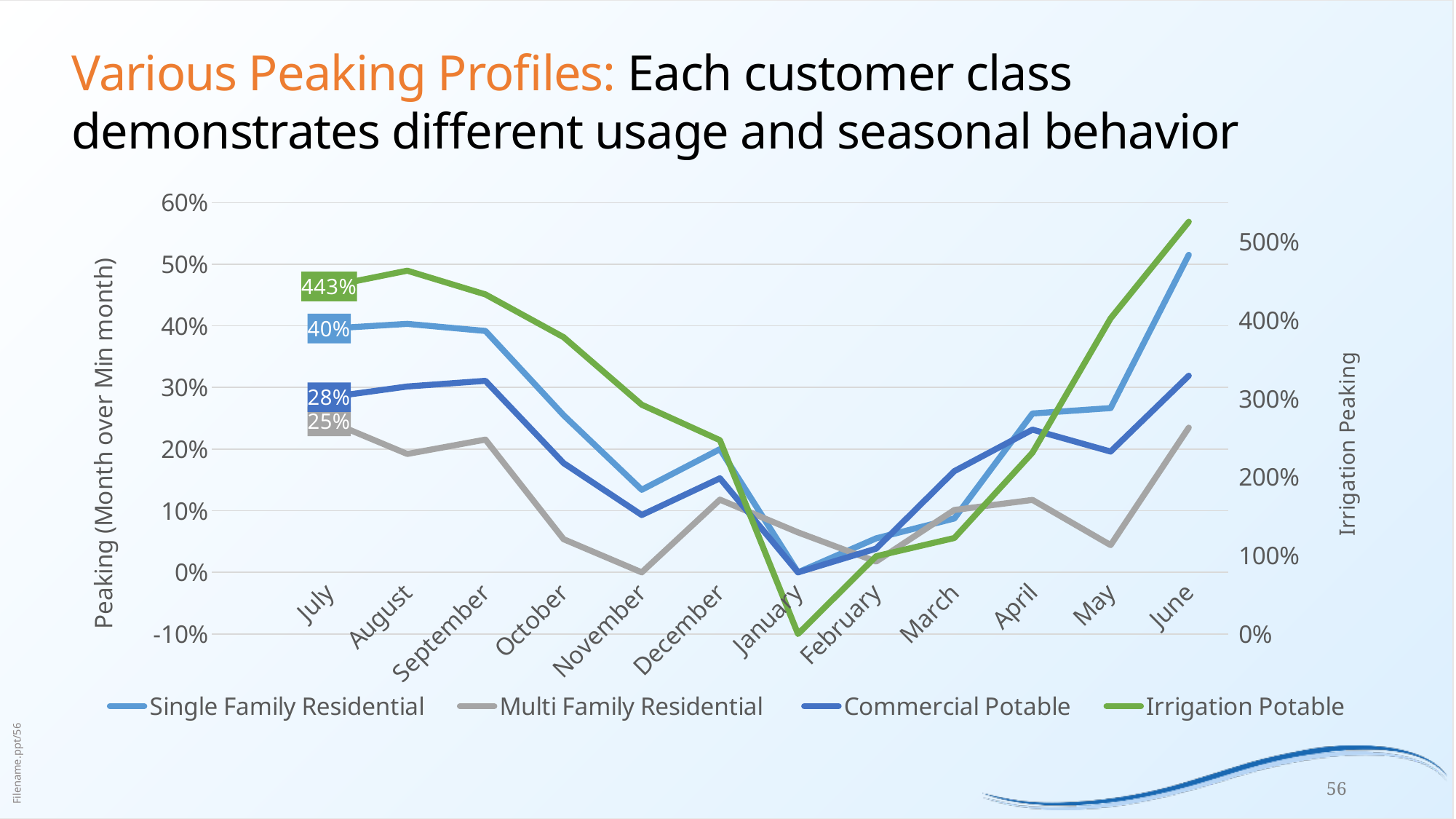
What is the July value for Single Family Residential? 40% In July, which is larger: Commercial Potable or Multi Family Residential? Commercial Potable What is the July value for Commercial Potable? 28% Does the Irrigation Potable line rise or fall from January to June? Rises Is the value for Multi Family Residential in November greater or less than 10%? less What is the title of the right-hand (secondary) vertical axis? Irrigation Peaking What kind of chart is shown on the slide? Line chart How many series does the legend list? 4 What is the difference between the July values for Single Family Residential and Multi Family Residential? 15 percentage points How many months are shown along the x axis? 12 What is the July value for Multi Family Residential? 25% What is the July value for Irrigation Potable? 443%